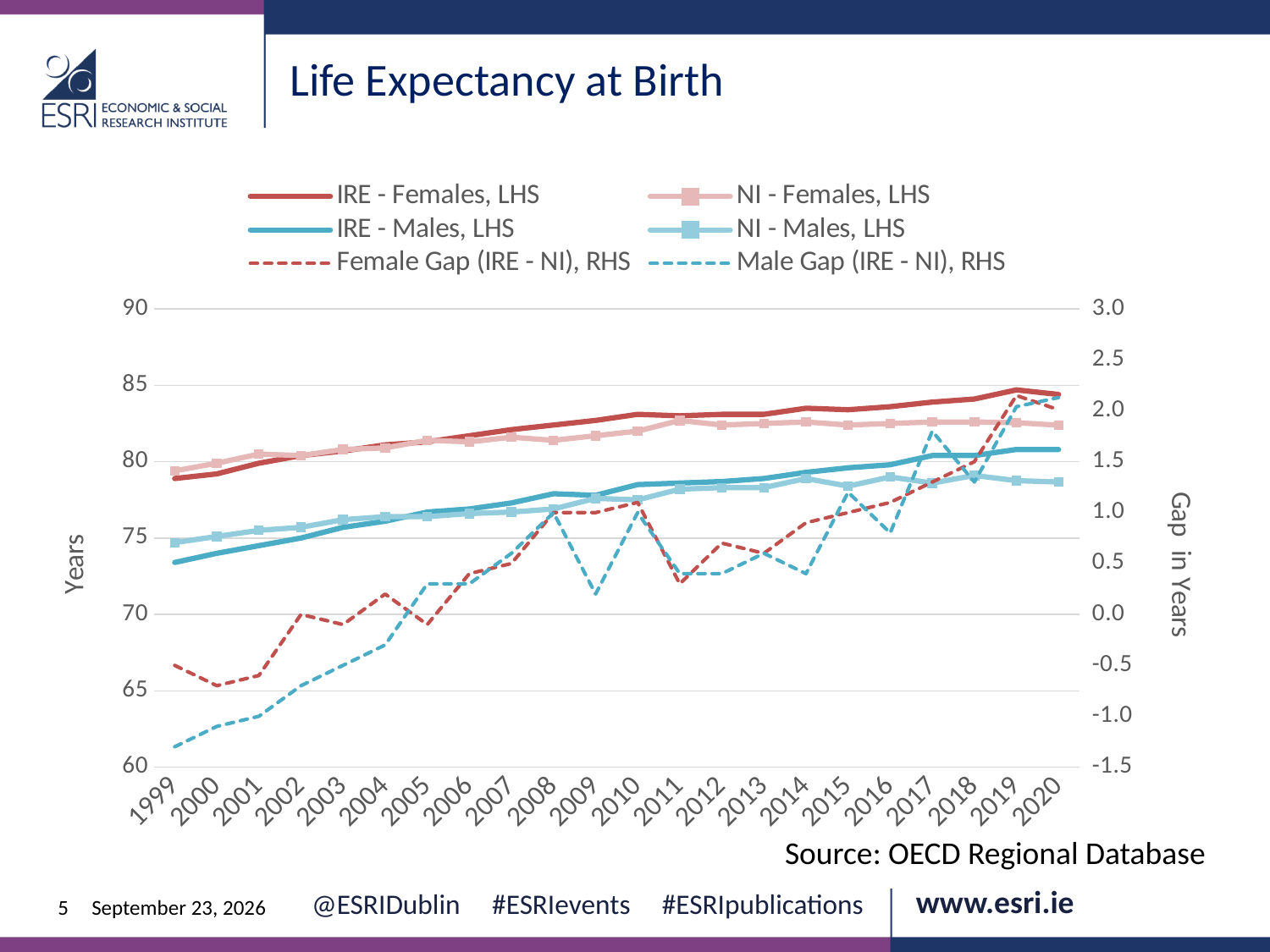
Is the value for Male Gap (IRE - NI), RHS in 2019 greater or less than 1.5? greater Is the value for IRE - Males, LHS in 1999 greater or less than 75? less In 2020, which is larger: IRE - Females, LHS or NI - Females, LHS? IRE - Females, LHS What is the title of the chart? Life Expectancy at Birth Is the value for Male Gap (IRE - NI), RHS in 1999 greater or less than -1.0? less Does the IRE - Females, LHS series rise or fall from 1999 to 2020? Rise What is the label of the right-hand vertical axis? Gap in Years What kind of chart is shown on the slide? Line chart How many years are shown along the x axis? 22 Which of the four life expectancy series (LHS) has the lowest value in 1999? IRE - Males, LHS How many series does the legend list? 6